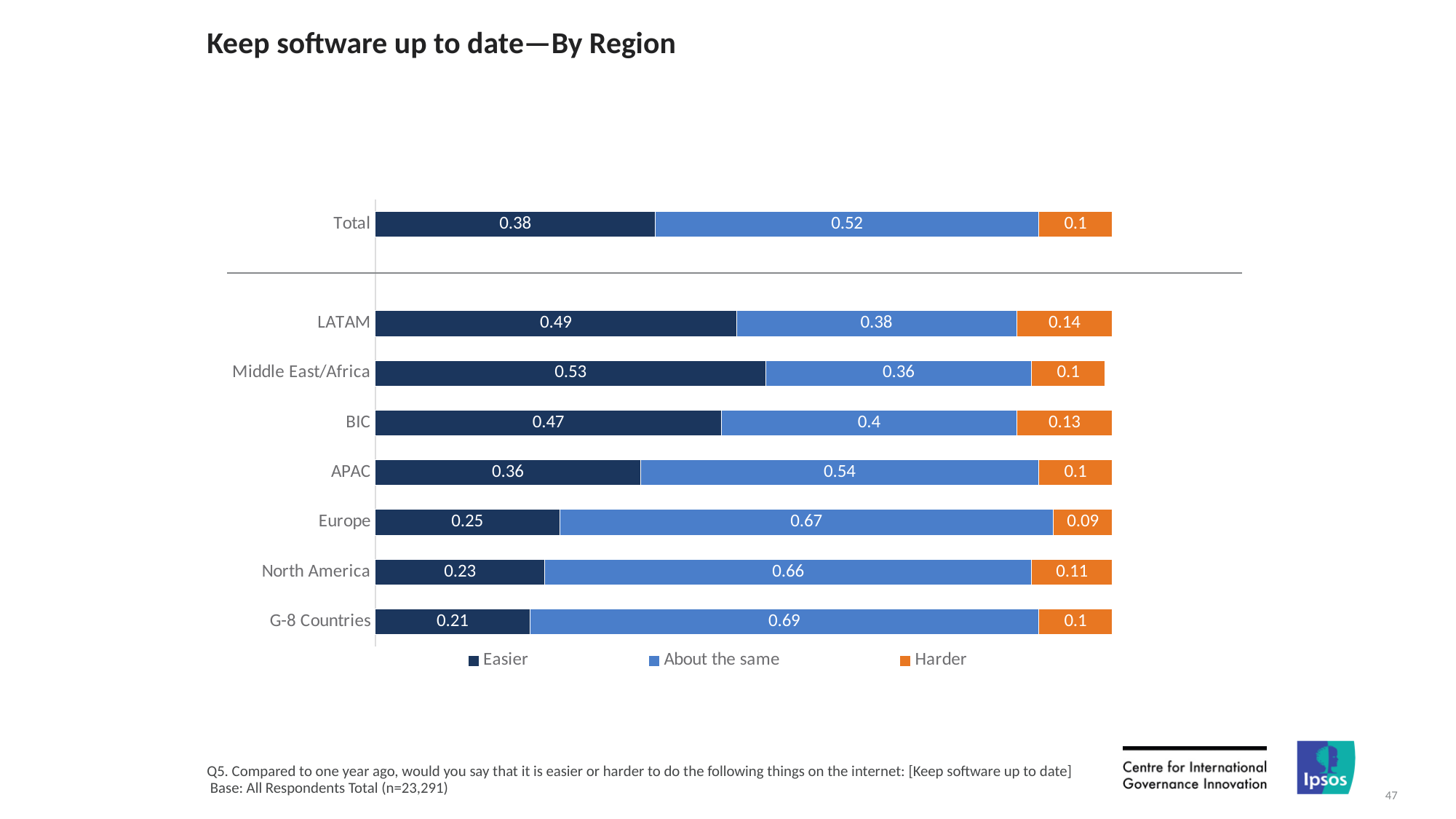
What kind of chart is shown on the slide? Stacked bar chart How many regions are shown on the chart, including Total? 8 Which region has the lowest 'Easier' value? G-8 Countries What is the difference between the 'Easier' values for LATAM and North America? 0.26 What is the total of the stacked bar for Europe? 1.01 Which region has the highest 'Easier' value? Middle East/Africa Which region has the lowest 'Harder' value? Europe What is the 'Harder' value for LATAM? 0.14 Which is larger, the 'About the same' value for APAC or for BIC? APAC What is the 'About the same' value for G-8 Countries? 0.69 How many series does the legend list? 3 What is the 'Easier' value for Middle East/Africa? 0.53